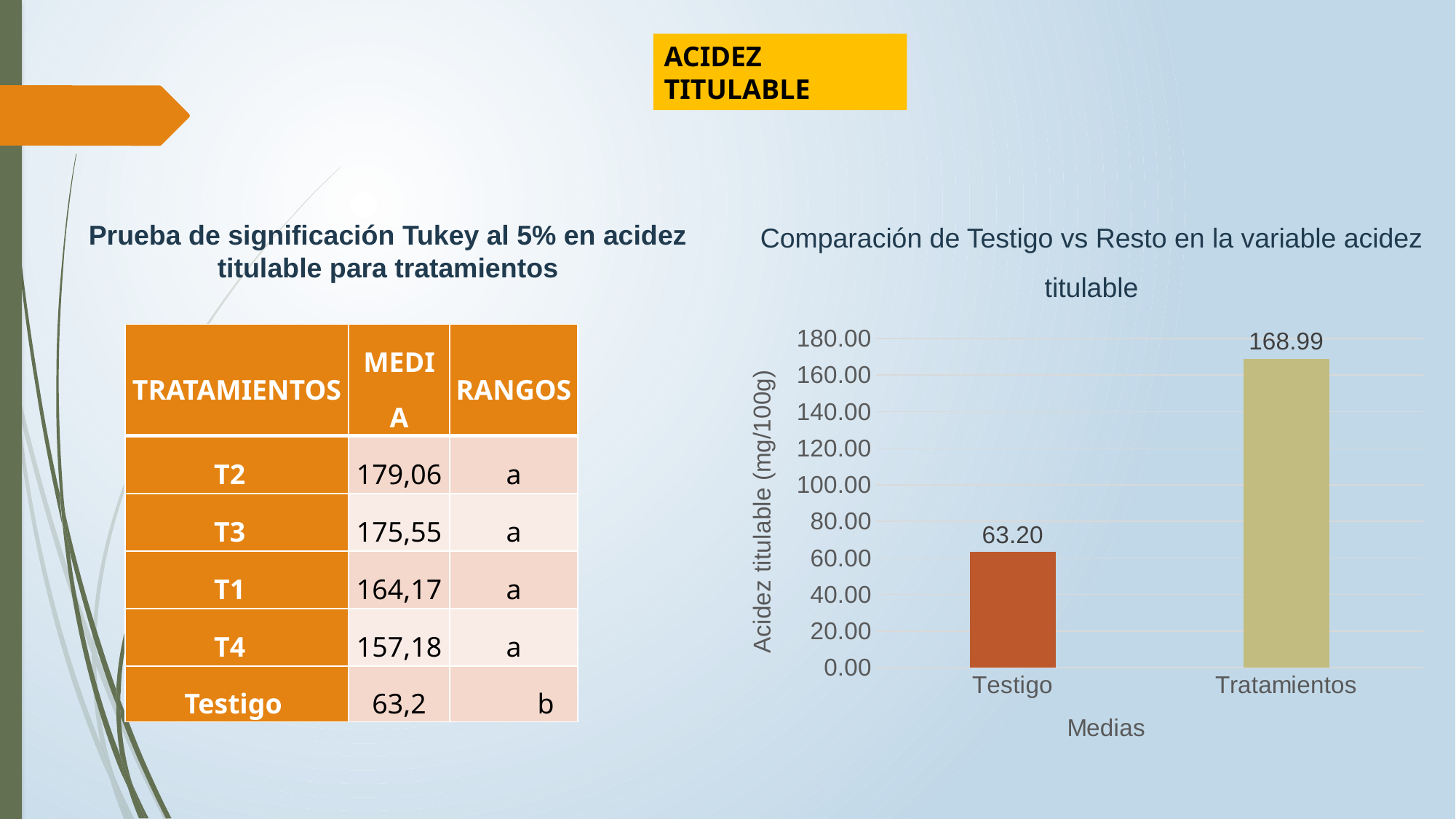
What is the title of the chart? Comparación de Testigo vs Resto en la variable acidez titulable Which category has the lowest value in the chart? Testigo What is the label of the y axis of the chart? Acidez titulable (mg/100g) Which category has the highest value in the chart? Tratamientos What is the value for Testigo in the chart? 63.20 Which is larger, the value for Testigo or the value for Tratamientos? Tratamientos Is the value for Tratamientos greater or less than 160.00? greater What is the value for Tratamientos in the chart? 168.99 How many categories are shown on the x axis of the chart? 2 What is the difference between the values for Tratamientos and Testigo? 105.79 What kind of chart is shown on the slide? bar chart Is the value for Testigo greater or less than 80.00? less